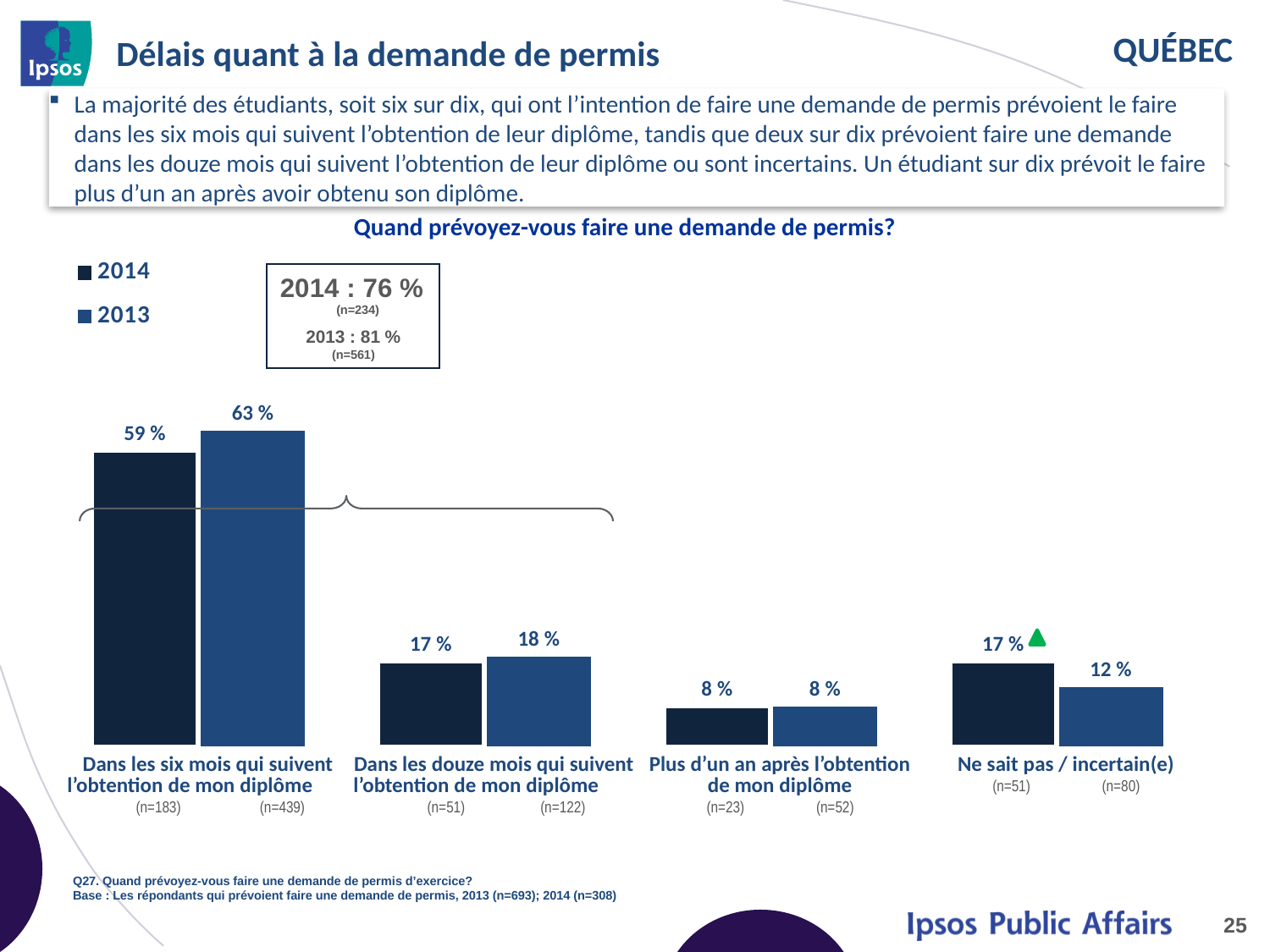
Which category has the lowest 2013 value? Plus d'un an après l'obtention de mon diplôme For "Ne sait pas / incertain(e)", which year has the larger value, 2014 or 2013? 2014 What is the 2013 value for "Dans les six mois qui suivent l'obtention de mon diplôme"? 63 % What is the 2013 value for "Ne sait pas / incertain(e)"? 12 % Which category has the highest 2014 value? Dans les six mois qui suivent l'obtention de mon diplôme How many series does the chart legend list? 2 What is the 2014 value for "Dans les six mois qui suivent l'obtention de mon diplôme"? 59 % What is the difference between the 2013 and 2014 values for "Dans les six mois qui suivent l'obtention de mon diplôme"? 4 % What is the title of the chart? Quand prévoyez-vous faire une demande de permis? How many categories are shown on the x axis of the chart? 4 What type of chart is shown on the slide? bar chart What is the 2014 value for "Plus d'un an après l'obtention de mon diplôme"? 8 %